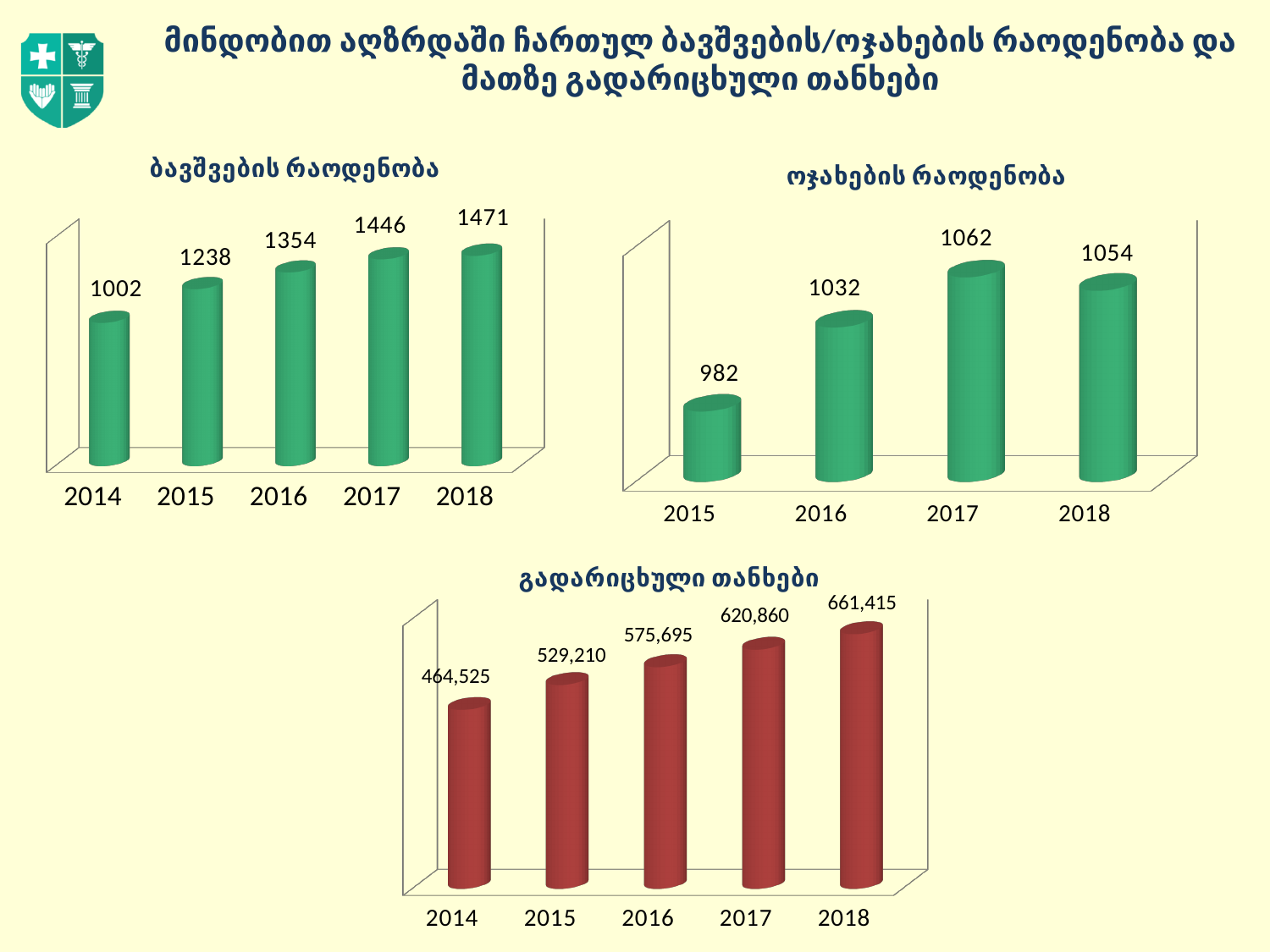
In the top-left chart (ბავშვების რაოდენობა), which year has the highest value? 2018 In the top-right chart (ოჯახების რაოდენობა), what is the value for 2016? 1032 In the top-left chart (ბავშვების რაოდენობა), what is the value for 2014? 1002 In the bottom chart (გადარიცხული თანხები), what is the difference between the values for 2016 and 2015? 46,485 What kind of chart is the bottom chart (გადარიცხული თანხები)? bar chart In the bottom chart (გადარიცხული თანხები), do the values rise or fall from 2014 to 2018? rise In the top-left chart (ბავშვების რაოდენობა), how many years are shown? 5 In the top-right chart (ოჯახების რაოდენობა), which year has the lowest value? 2015 In the top-left chart (ბავშვების რაოდენობა), what is the difference between the values for 2018 and 2014? 469 In the top-right chart (ოჯახების რაოდენობა), which is larger, the value for 2017 or the value for 2018? 2017 In the top-right chart (ოჯახების რაოდენობა), how many years are shown? 4 In the bottom chart (გადარიცხული თანხები), what is the value for 2017? 620,860